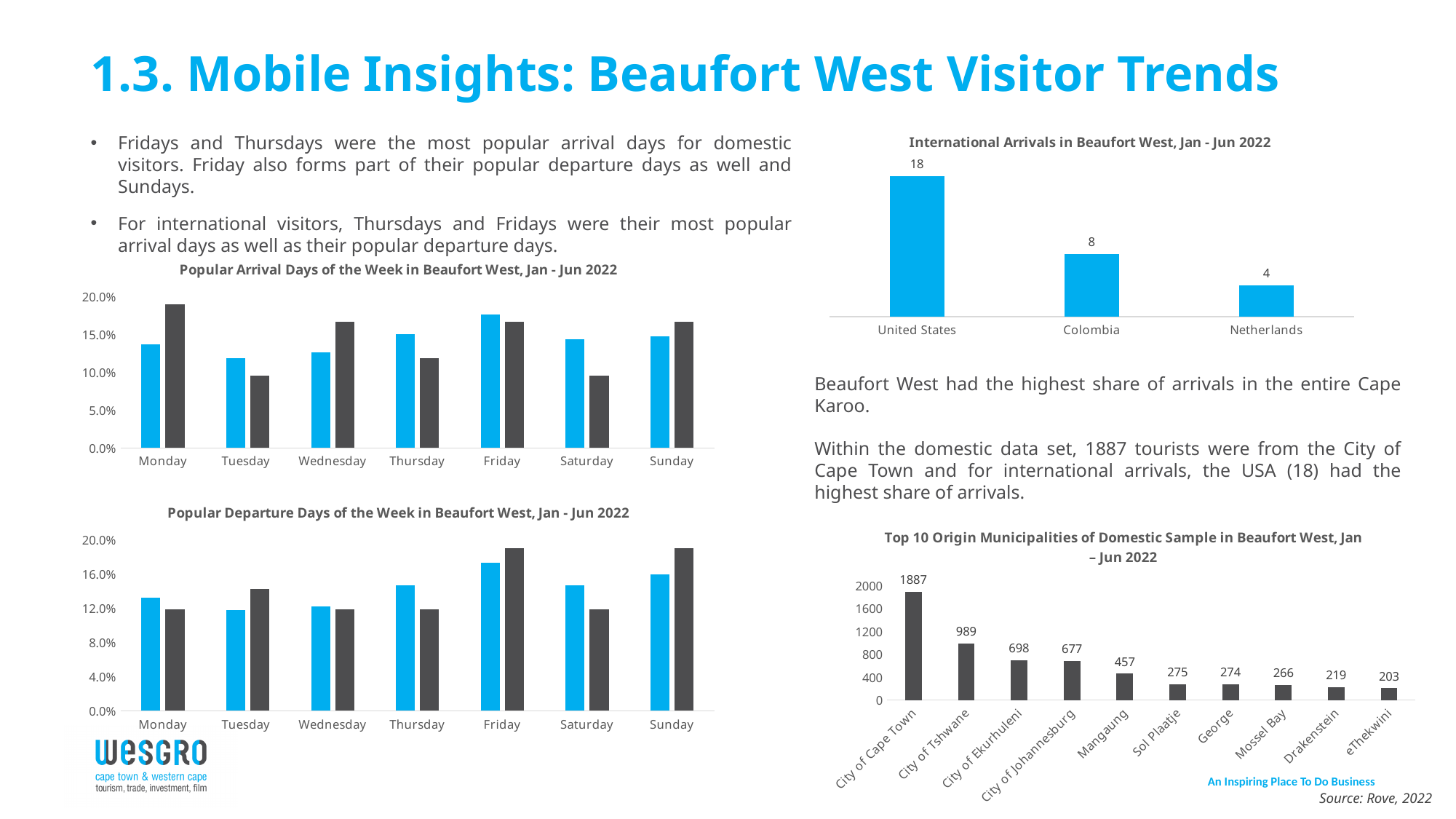
In the International Arrivals in Beaufort West chart, what is the value for Colombia? 8 In the International Arrivals in Beaufort West chart, which country has the lowest value? Netherlands In the Top 10 Origin Municipalities chart, what is the difference between City of Cape Town and City of Tshwane? 898 In the International Arrivals in Beaufort West chart, what is the value for the United States? 18 In the Top 10 Origin Municipalities chart, what is the value for City of Tshwane? 989 In the Top 10 Origin Municipalities chart, which municipality has the highest value? City of Cape Town In the International Arrivals in Beaufort West chart, what is the difference between the United States and Colombia? 10 In the Top 10 Origin Municipalities chart, do the values rise or fall from left to right? fall In the Top 10 Origin Municipalities chart, what is the value for Mangaung? 457 How many days of the week are shown in the Popular Arrival Days of the Week in Beaufort West chart? 7 What kind of chart is the Popular Departure Days of the Week in Beaufort West chart? bar chart How many countries are shown in the International Arrivals in Beaufort West chart? 3